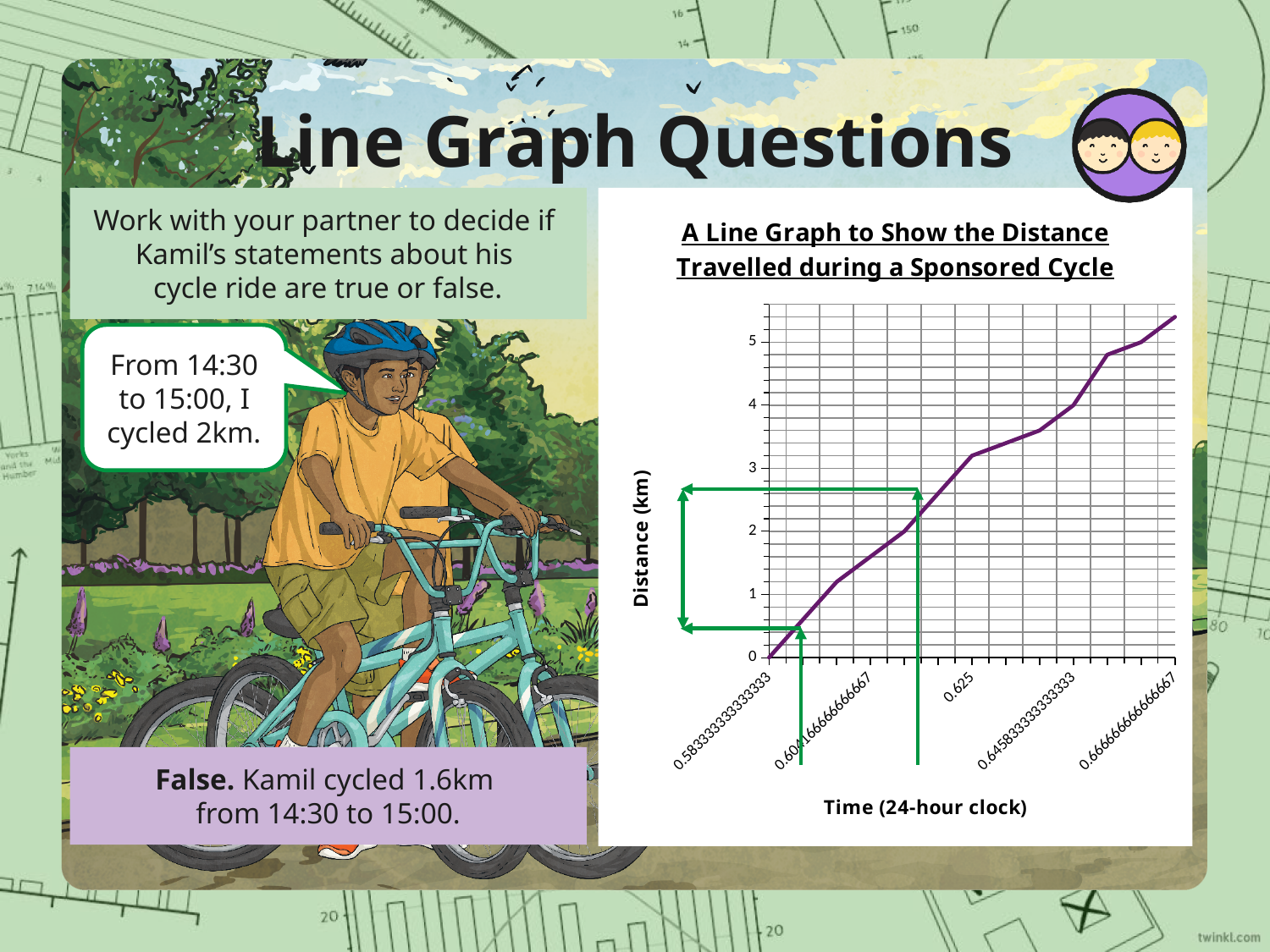
What is the label on the vertical axis of the chart? Distance (km) What kind of chart is shown on the slide? line chart How many labelled tick values are shown on the x axis of the chart? 5 What is the highest value labelled on the vertical axis of the chart? 5 At which x-axis label does the line reach its highest value? 0.666666666666667 Is the value of the line at the x-axis label 0.604166666666667 greater or less than 2? less What is the title of the chart? A Line Graph to Show the Distance Travelled during a Sponsored Cycle Is the value of the line at the x-axis label 0.583333333333333 greater or less than 1? less Is the value of the line at the x-axis label 0.666666666666667 greater or less than 5? greater Which is larger: the value of the line at 0.625 or at 0.604166666666667? 0.625 Does the plotted line rise or fall as you move from left to right along the x axis? rise At which x-axis label is the line at its lowest value? 0.583333333333333